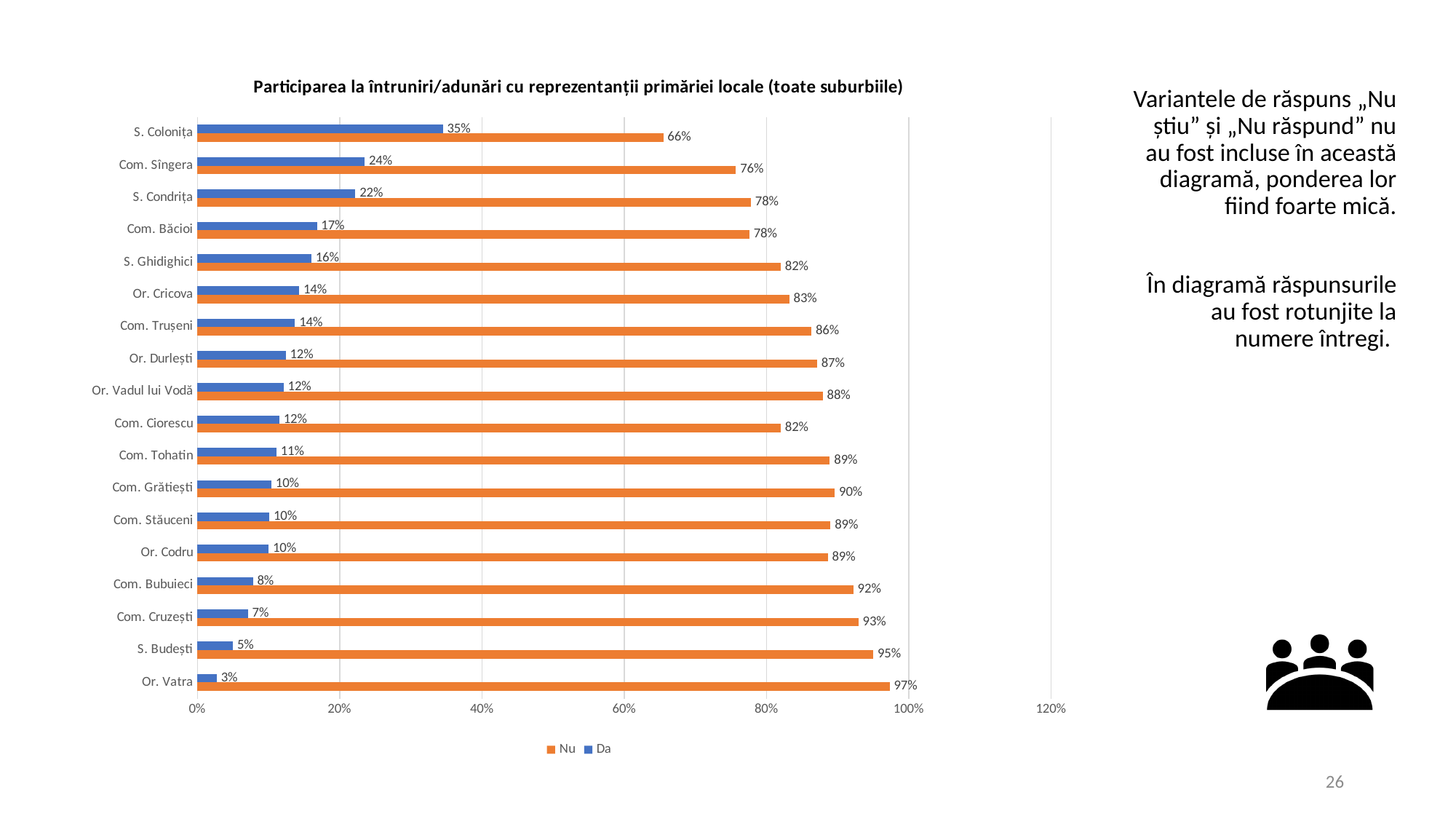
What is the 'Nu' value for Com. Ciorescu? 82% How many series does the legend list? 2 Which is larger, the 'Da' value for Com. Băcioi or the 'Da' value for S. Ghidighici? Com. Băcioi Which category has the lowest 'Nu' value? S. Colonița What is the 'Nu' value for Or. Vatra? 97% What is the 'Da' value for S. Colonița? 35% What kind of chart is shown on the slide? Bar chart What is the difference between the 'Nu' and 'Da' values for Com. Sîngera? 52% Which category has the highest 'Da' value? S. Colonița Which colour represents the 'Nu' series? Orange How many categories (localities) are shown on the chart? 18 Which category has the lowest 'Da' value? Or. Vatra